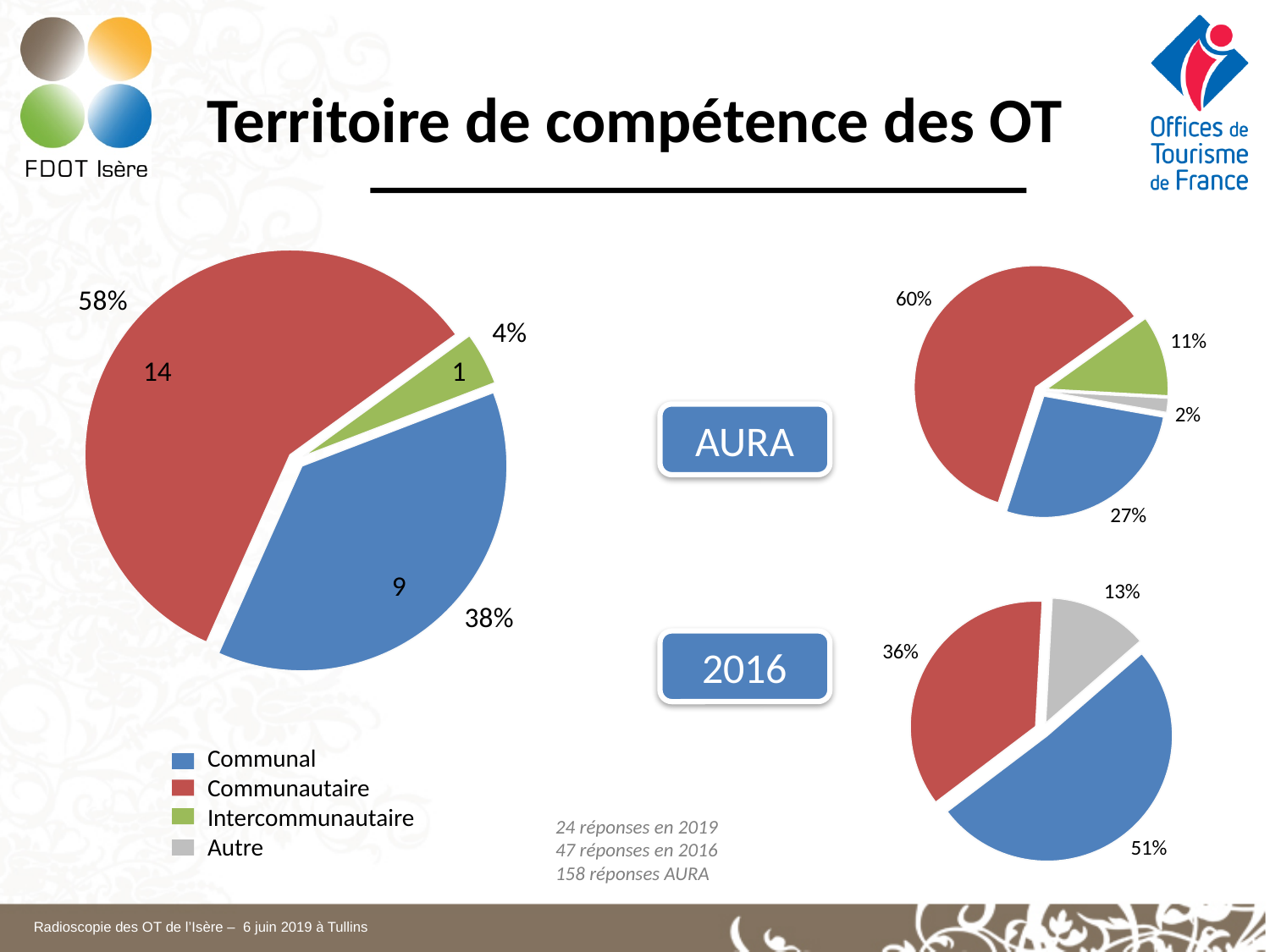
On the large pie chart on the left, what is the difference in counts between the Communautaire and Communal slices? 5 On the large pie chart on the left, which category has the smallest slice? Intercommunautaire On the 2016 pie chart, which is larger, the Communautaire slice or the Autre slice? Communautaire On the AURA pie chart, what percentage is shown for the Communal slice? 27% On the large pie chart on the left, how many slices does the pie have? 3 What type of chart is used on this slide? Pie chart On the 2016 pie chart, what percentage is shown for the Communal slice? 51% On the large pie chart on the left, what count is shown for the Communal slice? 9 On the AURA pie chart, which category has the largest slice? Communautaire How many categories does the legend list? 4 On the AURA pie chart, what percentage is shown for the Autre slice? 2% On the large pie chart on the left, what percentage is shown for the Communautaire slice? 58%